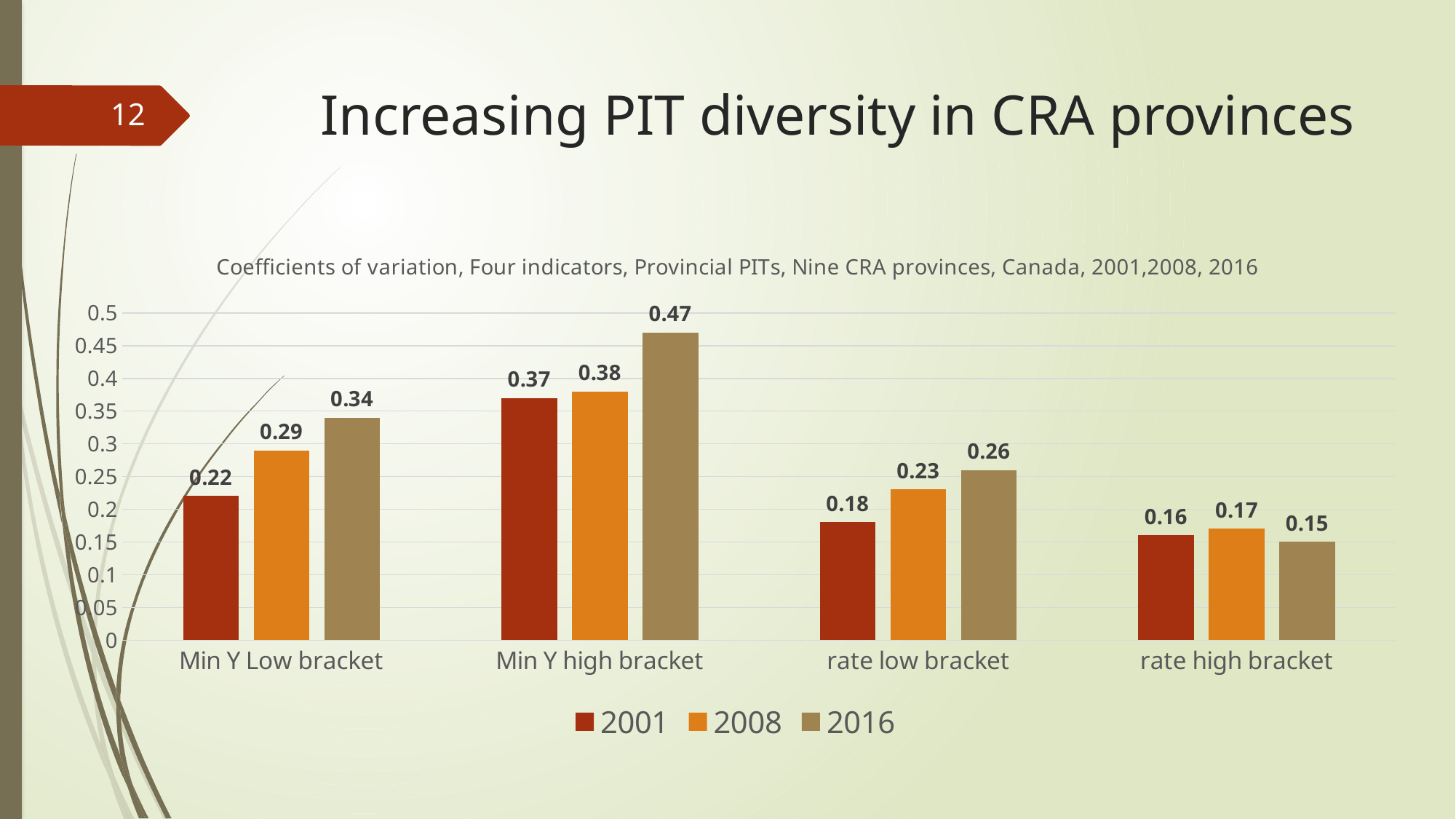
Which category has the lowest value for 2001? rate high bracket What kind of chart is shown on the slide? bar chart What is the value for Min Y Low bracket in 2008? 0.29 How many series does the legend list? 3 Which category has the highest value for 2016? Min Y high bracket Which series is shown in orange in the legend? 2008 Do the values for rate low bracket rise or fall from 2001 to 2016? rise What is the difference between the 2016 and 2001 values for Min Y Low bracket? 0.12 What is the value for rate low bracket in 2001? 0.18 What is the value for Min Y high bracket in 2016? 0.47 Which is larger for rate high bracket: the 2008 value or the 2016 value? 2008 How many categories are shown on the x axis? 4